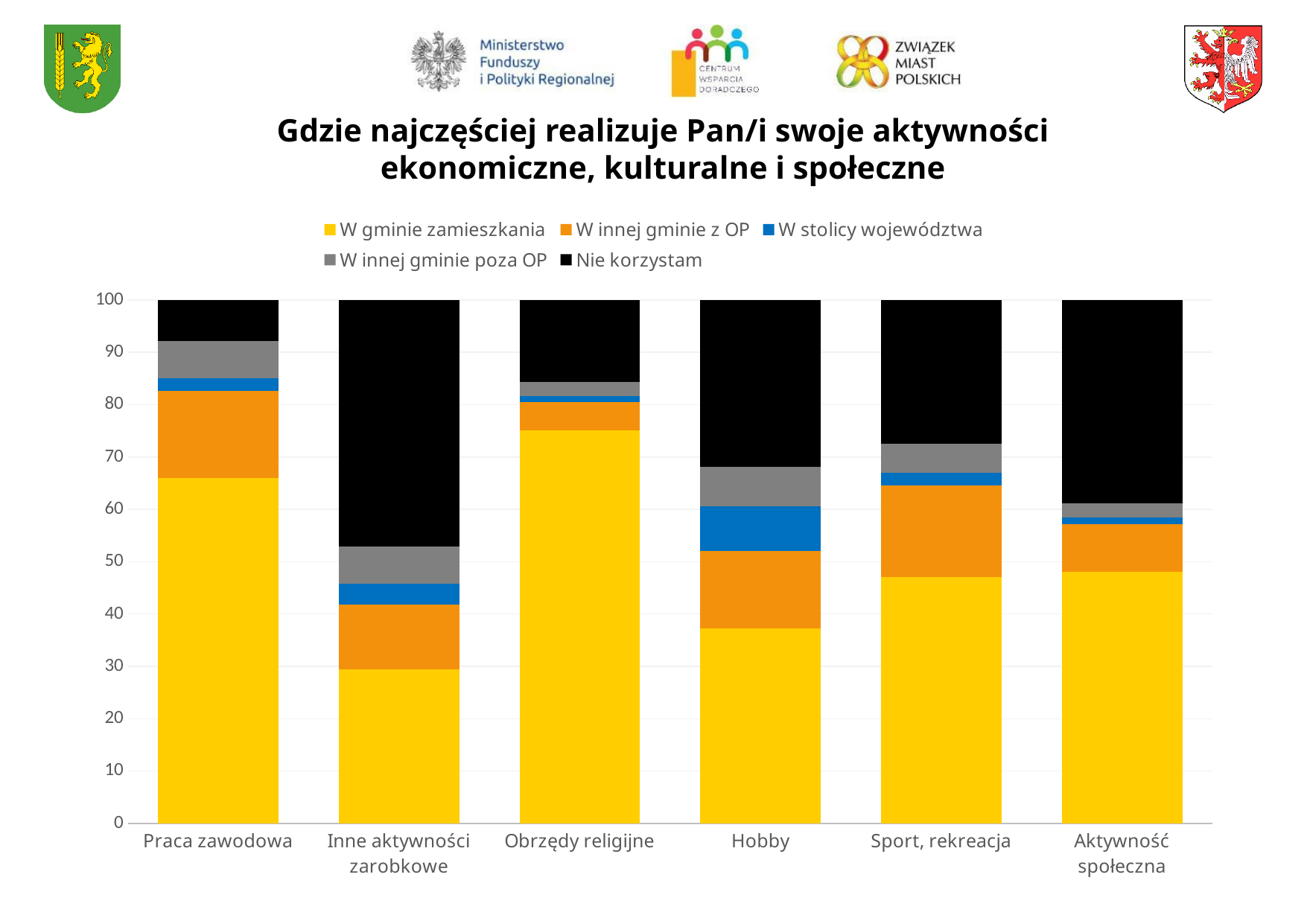
How many activity categories are shown on the x axis? 6 Which category has the smallest 'Nie korzystam' segment? Praca zawodowa Which category has the smallest 'W gminie zamieszkania' segment? Inne aktywności zarobkowe Which category has the largest 'Nie korzystam' segment? Inne aktywności zarobkowe Is the 'W gminie zamieszkania' value for Praca zawodowa greater or less than 60? greater Which category has the largest 'W gminie zamieszkania' segment? Obrzędy religijne How many series does the legend list? 5 Is the 'W gminie zamieszkania' value for Inne aktywności zarobkowe greater or less than 40? less Which category has the largest 'W stolicy województwa' segment? Hobby Which has the larger 'W gminie zamieszkania' segment, Hobby or Sport, rekreacja? Sport, rekreacja What kind of chart is shown on the slide? Stacked bar chart What is the total height of the stacked bar for Hobby? 100